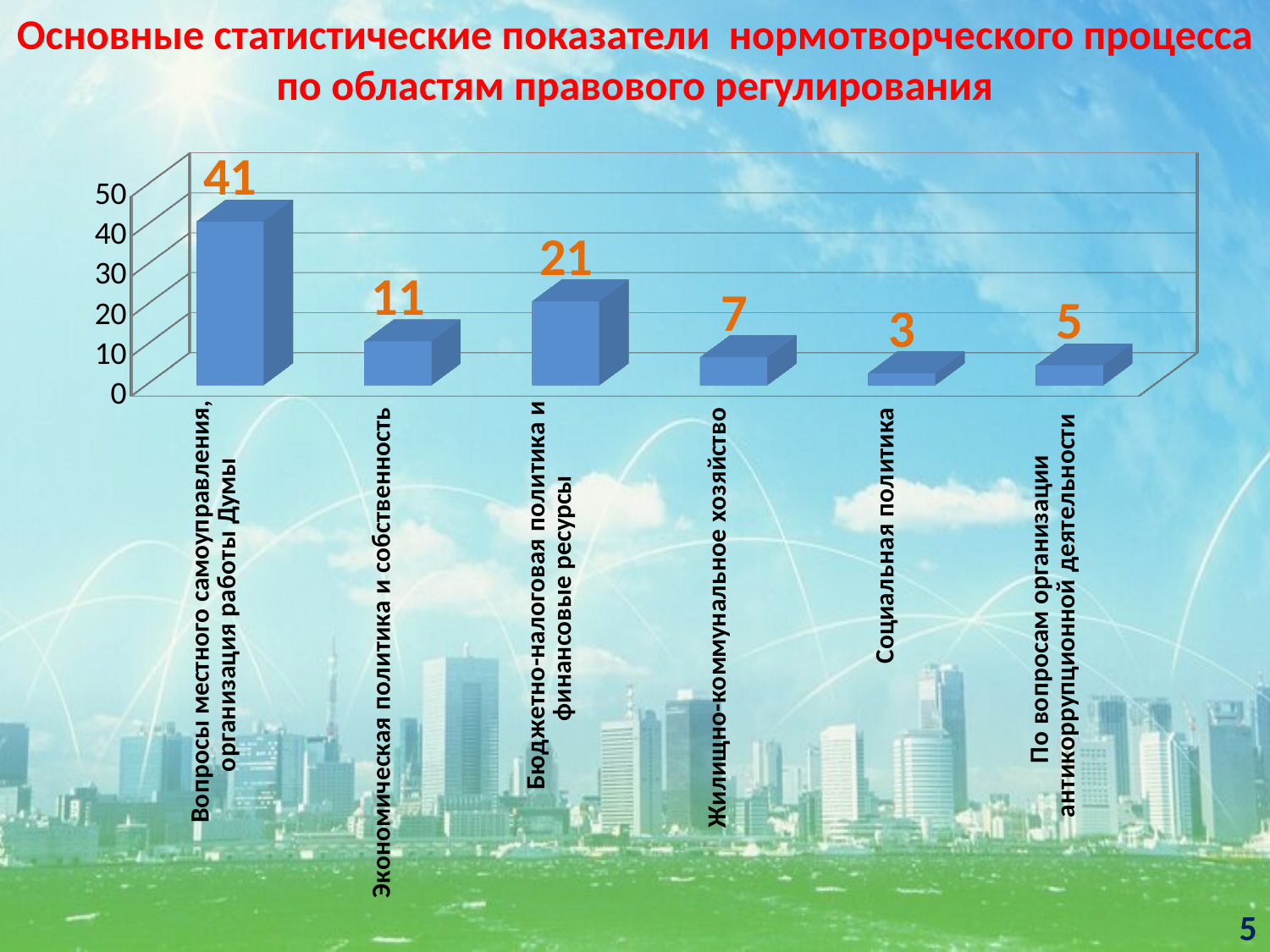
Which is larger: the value for Жилищно-коммунальное хозяйство or the value for По вопросам организации антикоррупционной деятельности? Жилищно-коммунальное хозяйство What is the value for Социальная политика? 3 Which category has the highest value? Вопросы местного самоуправления, организация работы Думы Which category has the lowest value? Социальная политика What is the difference between the values for Бюджетно-налоговая политика и финансовые ресурсы and Экономическая политика и собственность? 10 What is the value for По вопросам организации антикоррупционной деятельности? 5 What kind of chart is shown on the slide? bar chart What is the value for Бюджетно-налоговая политика и финансовые ресурсы? 21 How many categories are shown in the chart? 6 What is the value for Вопросы местного самоуправления, организация работы Думы? 41 Is the value for Экономическая политика и собственность greater or less than 20? less What is the title of the slide? Основные статистические показатели нормотворческого процесса по областям правового регулирования